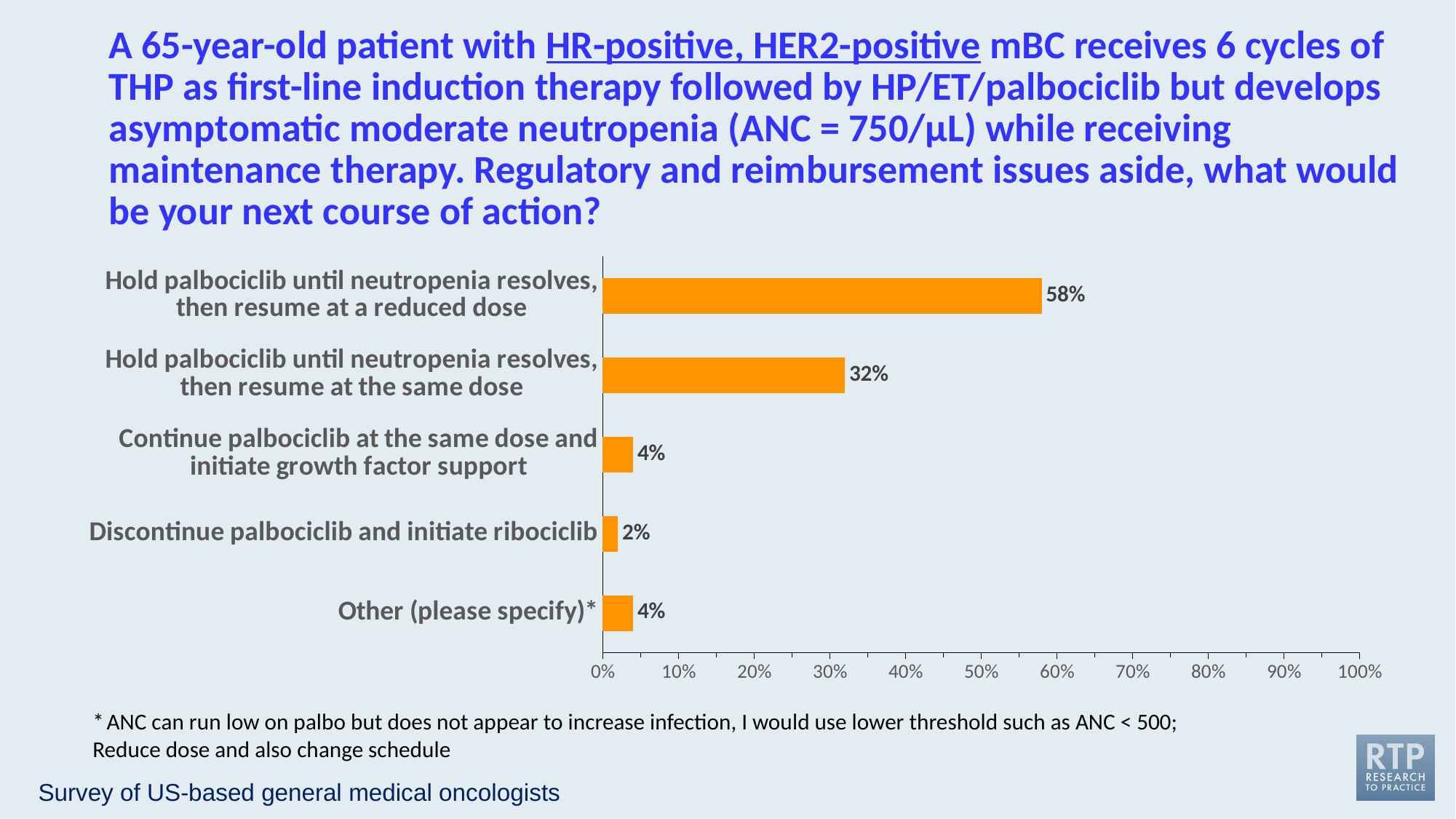
Which response option received the lowest percentage? Discontinue palbociclib and initiate ribociclib What type of chart is shown on the slide? Bar chart Which response option received the highest percentage? Hold palbociclib until neutropenia resolves, then resume at a reduced dose Is the value for "Hold palbociclib until neutropenia resolves, then resume at a reduced dose" greater or less than 50%? greater How many response options are shown in the chart? 5 What is the maximum value shown on the x axis of the chart? 100% What percentage of respondents chose "Discontinue palbociclib and initiate ribociclib"? 2% What percentage of respondents chose "Hold palbociclib until neutropenia resolves, then resume at a reduced dose"? 58% What is the difference in percentage points between "Hold palbociclib until neutropenia resolves, then resume at a reduced dose" and "Hold palbociclib until neutropenia resolves, then resume at the same dose"? 26 percentage points Which received a larger share: "Continue palbociclib at the same dose and initiate growth factor support" or "Discontinue palbociclib and initiate ribociclib"? Continue palbociclib at the same dose and initiate growth factor support What percentage of respondents chose "Hold palbociclib until neutropenia resolves, then resume at the same dose"? 32% What percentage of respondents chose "Continue palbociclib at the same dose and initiate growth factor support"? 4%